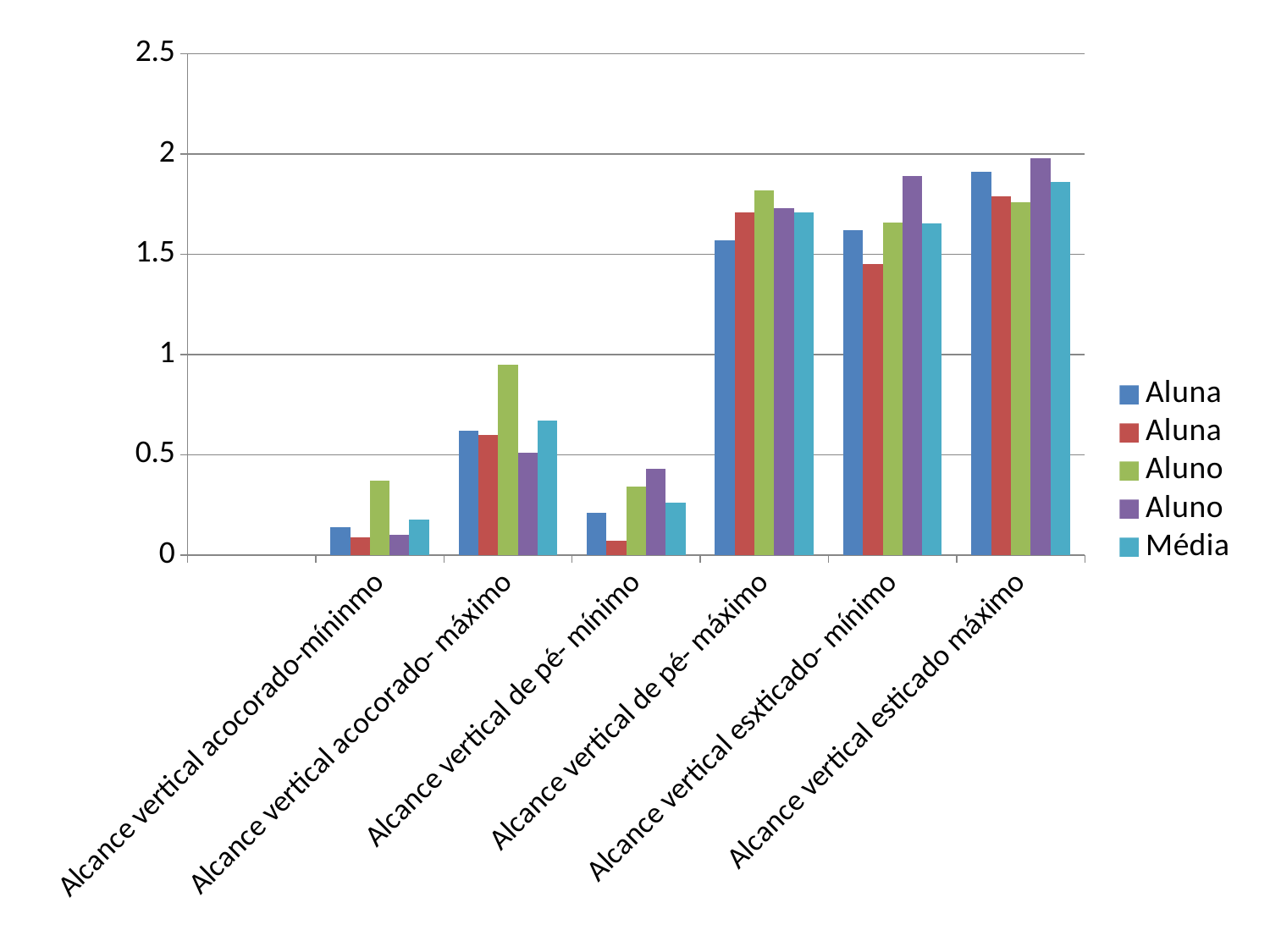
What kind of chart is shown on the slide? bar chart Is the Média value for "Alcance vertical acocorado- máximo" greater or less than 0.5? greater Which category has the highest Média value? Alcance vertical esticado máximo Which is larger: the Média value for "Alcance vertical acocorado- máximo" or for "Alcance vertical de pé- mínimo"? Alcance vertical acocorado- máximo Is the Média value for "Alcance vertical esticado máximo" greater or less than 1.5? greater Is the Média value for "Alcance vertical acocorado-míninmo" greater or less than 0.5? less What is the last entry listed in the legend? Média Which category has the lowest Média value? Alcance vertical acocorado-míninmo How many series does the legend list? 5 How many categories are shown on the x axis? 6